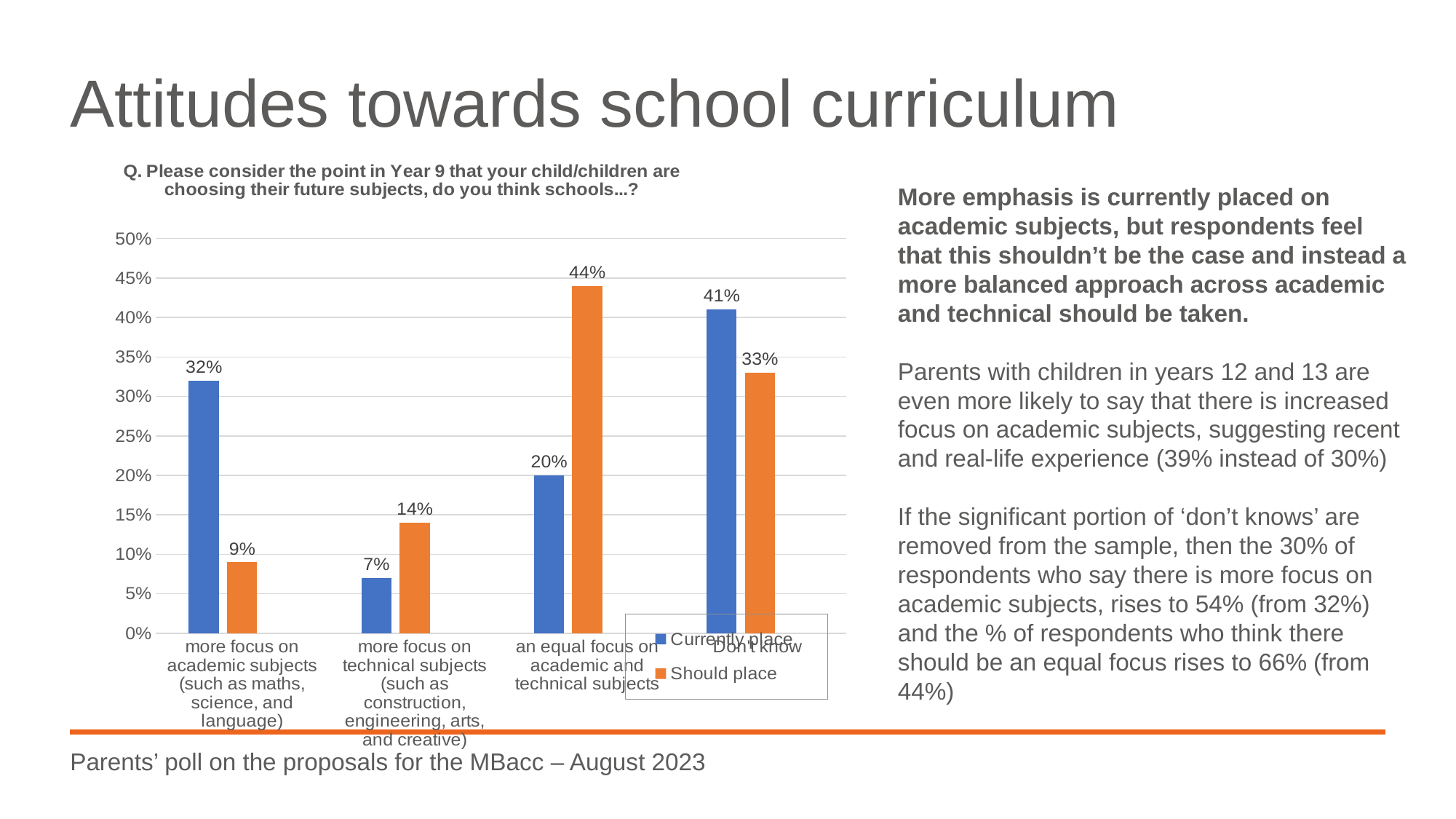
What is the 'Should place' value for 'an equal focus on academic and technical subjects'? 44% What is the 'Should place' value for 'more focus on technical subjects'? 14% For 'more focus on academic subjects', which is larger: the 'Currently place' value or the 'Should place' value? Currently place How many series does the legend list? 2 Which series is shown in orange in the legend? Should place Which category has the lowest 'Currently place' value? more focus on technical subjects Which category has the highest 'Should place' value? an equal focus on academic and technical subjects What is the 'Currently place' value for 'more focus on academic subjects'? 32% What is the difference between the 'Should place' and 'Currently place' values for 'an equal focus on academic and technical subjects'? 24% How many categories are shown on the x axis? 4 What kind of chart is shown on the slide? bar chart What is the 'Currently place' value for 'Don't know'? 41%